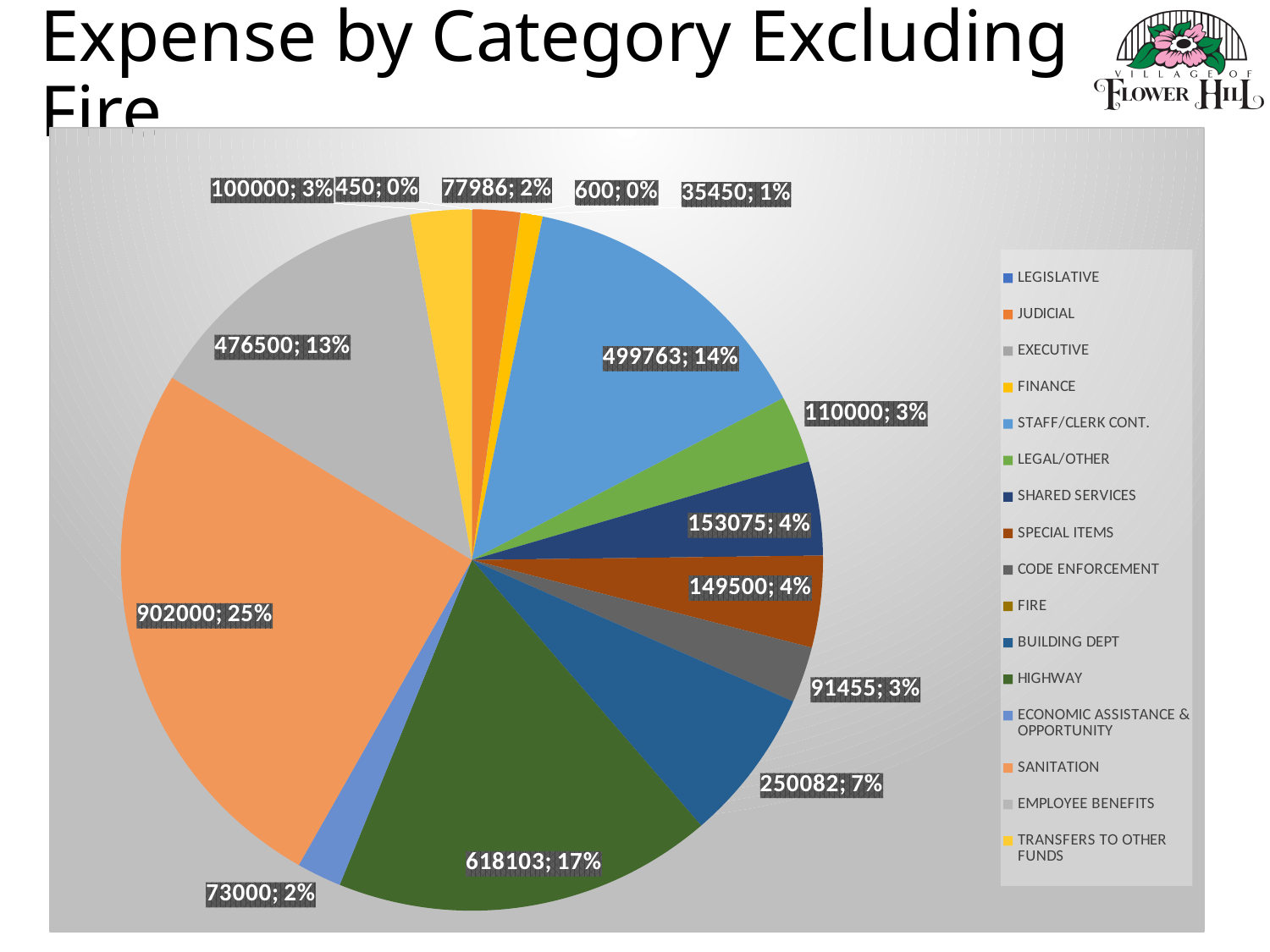
Which category has the largest slice of the pie? SANITATION What share of the pie does SANITATION represent? 25% Which is larger, STAFF/CLERK CONT. or BUILDING DEPT? STAFF/CLERK CONT. What is the difference between the SANITATION value and the HIGHWAY value? 283897 How many categories does the legend list? 16 What type of chart is shown on the slide? pie chart What share of the pie does BUILDING DEPT represent? 7% What share of the pie does STAFF/CLERK CONT. represent? 14% What is the value shown for EMPLOYEE BENEFITS? 476500 What is the title of the chart? Expense by Category Excluding Fire What is the value shown for HIGHWAY? 618103 Which is larger, HIGHWAY or EMPLOYEE BENEFITS? HIGHWAY